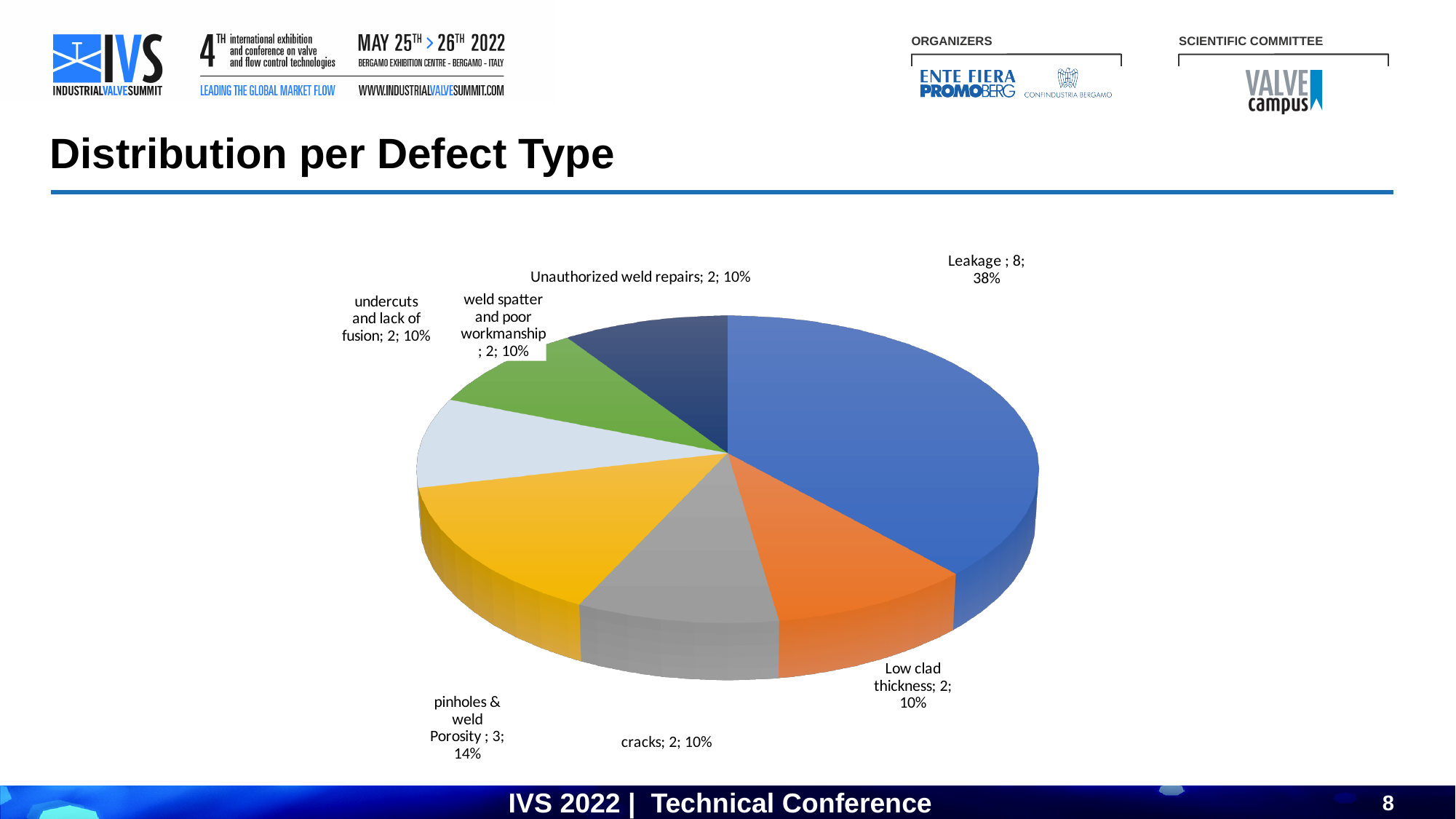
What is the count for Leakage? 8 What kind of chart is shown on the slide? Pie chart Which defect type has the largest slice? Leakage What is the difference in count between Leakage and pinholes & weld Porosity? 5 How many defect types (slices) does the pie chart show? 7 What is the count for pinholes & weld Porosity? 3 What share of the pie does Leakage represent? 38% What share of the pie does pinholes & weld Porosity represent? 14% What percentage share is shown for Unauthorized weld repairs? 10% Which is larger, the count for cracks or the count for pinholes & weld Porosity? pinholes & weld Porosity What is the title of the chart on the slide? Distribution per Defect Type What is the total count across all defect types in the pie chart? 21